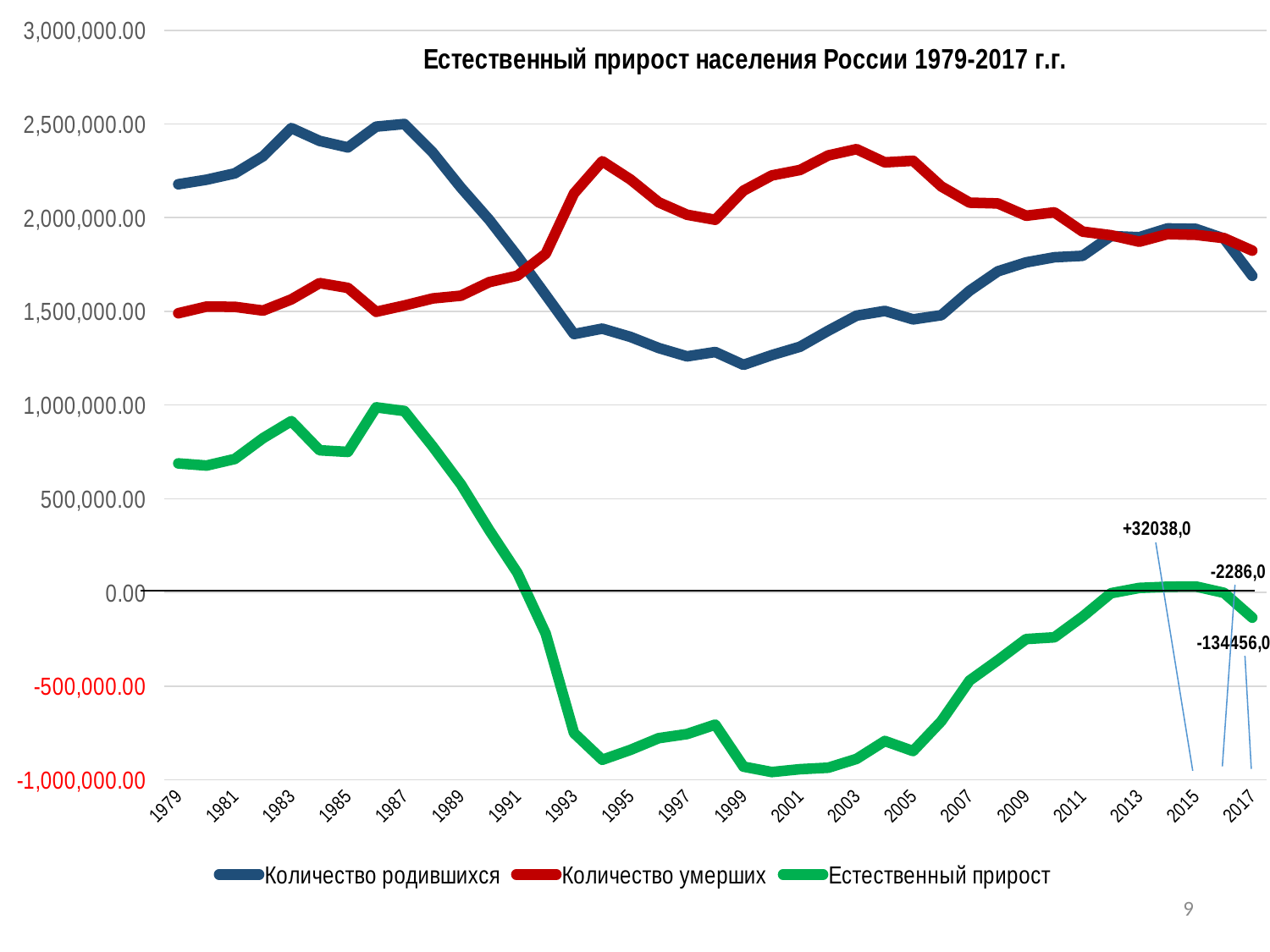
What is the labelled value of Естественный прирост for 2015? +32038,0 Is the value of Естественный прирост in 2000 greater or less than -500,000.00? less What kind of chart is shown on the slide? line chart In 2003, which is larger: Количество родившихся or Количество умерших? Количество умерших Does Естественный прирост rise or fall between 1987 and 1993? fall What is the labelled value of Естественный прирост for 2017? -134456,0 How many series does the legend list? 3 Which series is drawn in green? Естественный прирост How many year labels are shown on the x axis? 20 What is the labelled value of Естественный прирост for 2016? -2286,0 Is the value of Количество родившихся in 1979 greater or less than 2,000,000.00? greater What is the title of the chart? Естественный прирост населения России 1979-2017 г.г.